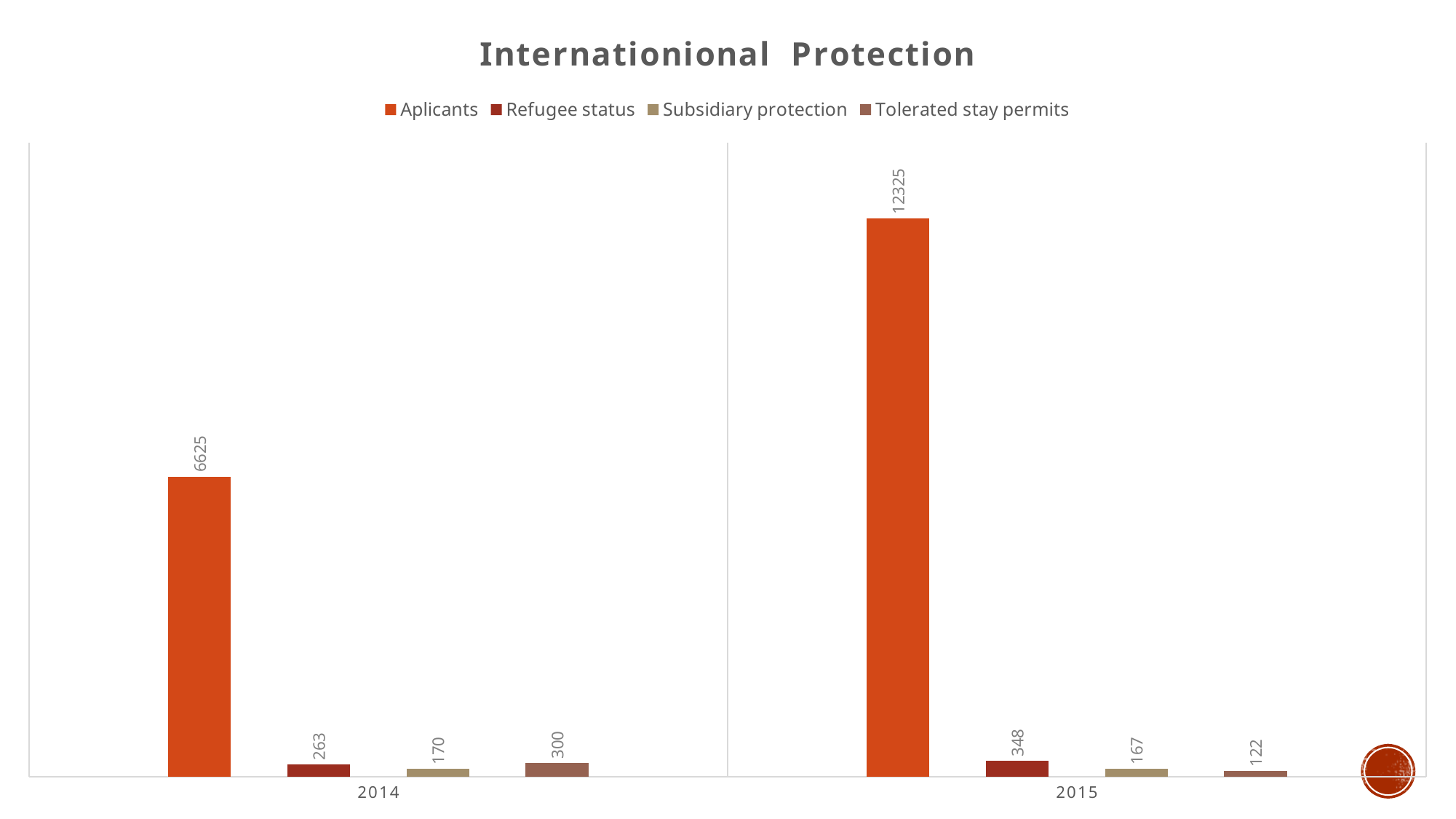
What kind of chart is shown? Bar chart What is the difference between the Aplicants values for 2015 and 2014? 5700 Which series has the highest value in 2015? Aplicants Which series has the lowest value in 2015? Tolerated stay permits What is the value for Refugee status in 2014? 263 How many series does the legend list? 4 Which is larger: Tolerated stay permits in 2014 or Refugee status in 2014? Tolerated stay permits in 2014 What is the value for Subsidiary protection in 2014? 170 Does the Aplicants value rise or fall from 2014 to 2015? Rise What is the value for Tolerated stay permits in 2015? 122 What is the value for Aplicants in 2015? 12325 How many categories are shown on the x axis? 2